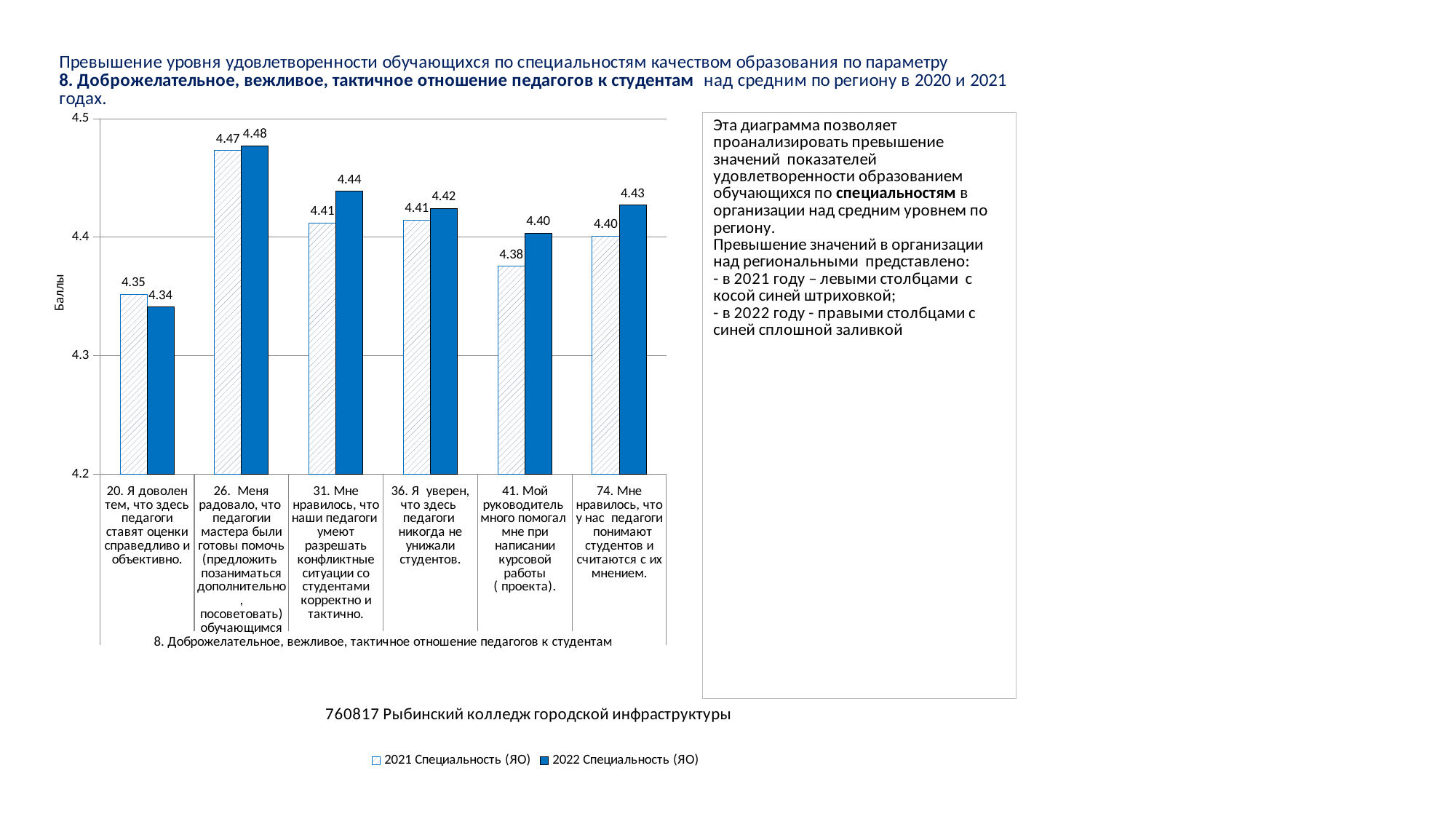
Which item has the lowest 2021 Специальность (ЯО) value? 20. Я доволен тем, что здесь педагоги ставят оценки справедливо и объективно What is the title of the vertical axis of the chart? Баллы What is the 2022 Специальность (ЯО) value for item 74 (Мне нравилось, что у нас педагоги понимают студентов)? 4.43 What is the 2022 Специальность (ЯО) value for item 26 (Меня радовало, что педагоги мастера были готовы помочь)? 4.48 What is the difference between the 2022 and 2021 Специальность (ЯО) values for item 31 (Мне нравилось, что наши педагоги умеют разрешать конфликтные ситуации)? 0.03 How many items (categories) are shown on the x axis of the chart? 6 For item 20 (Я доволен тем, что здесь педагоги ставят оценки справедливо и объективно), which is larger: the 2021 or the 2022 Специальность (ЯО) value? 2021 Специальность (ЯО) What kind of chart is shown on the slide? bar chart Is the 2021 Специальность (ЯО) value for item 41 greater or less than 4.3? greater Which item has the highest 2022 Специальность (ЯО) value? 26. Меня радовало, что педагоги мастера были готовы помочь What is the 2021 Специальность (ЯО) value for item 41 (Мой руководитель много помогал мне при написании курсовой работы)? 4.38 How many series does the chart legend list? 2